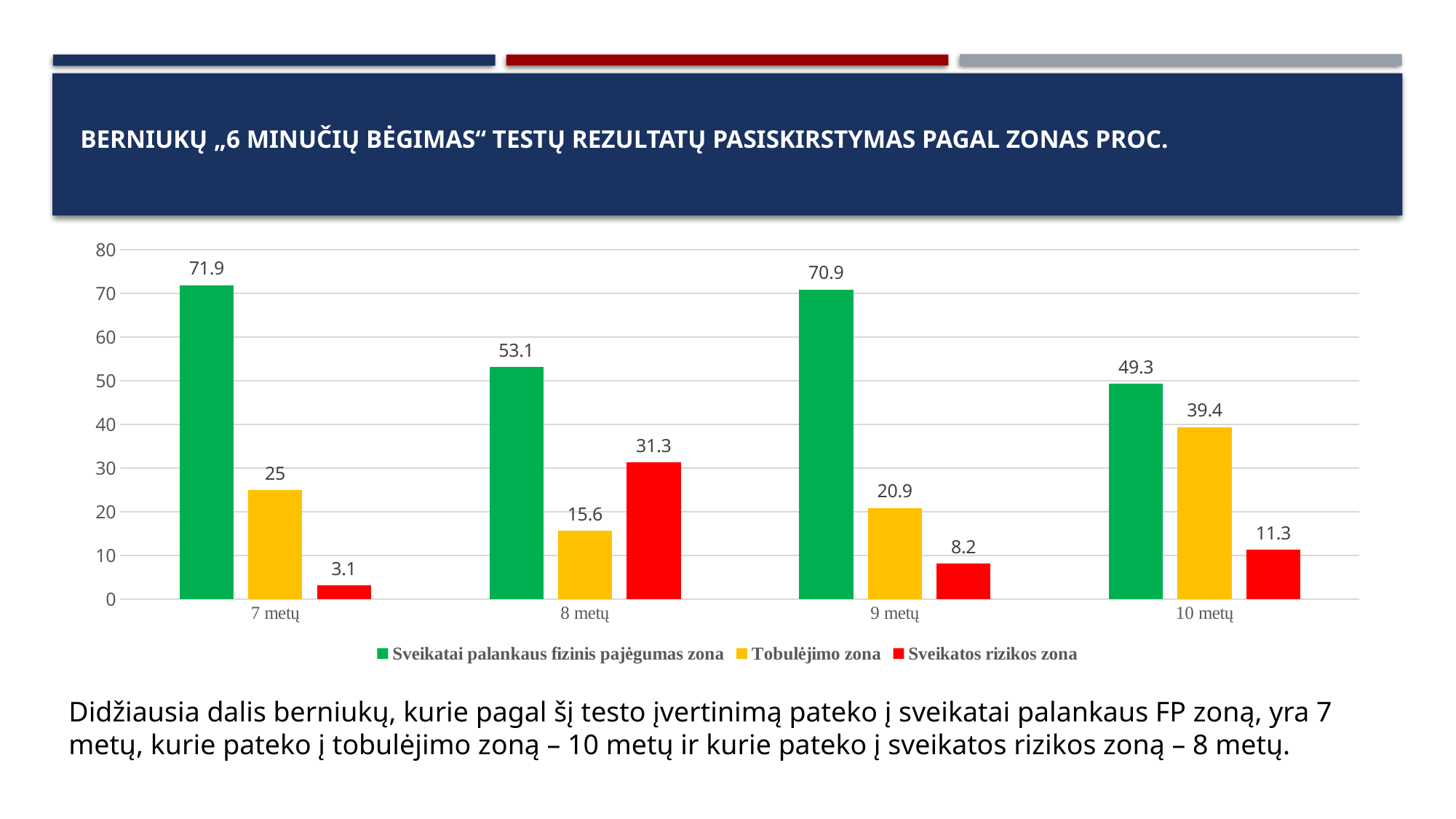
How many series does the legend list? 3 What is the value for "Sveikatai palankaus fizinis pajėgumas zona" for 7 metų? 71.9 What kind of chart is shown on the slide? Bar chart Which age group has the highest value for "Sveikatos rizikos zona"? 8 metų Which is larger: the "Sveikatos rizikos zona" value for 9 metų or for 10 metų? 10 metų Is the value for "Sveikatai palankaus fizinis pajėgumas zona" for 9 metų greater or less than 60? greater What is the value for "Sveikatos rizikos zona" for 8 metų? 31.3 What is the value for "Tobulėjimo zona" for 10 metų? 39.4 What is the difference between the "Tobulėjimo zona" values for 10 metų and 7 metų? 14.4 How many age groups are shown on the x axis? 4 What colour represents "Tobulėjimo zona" in the chart? Yellow Which age group has the lowest value for "Sveikatai palankaus fizinis pajėgumas zona"? 10 metų